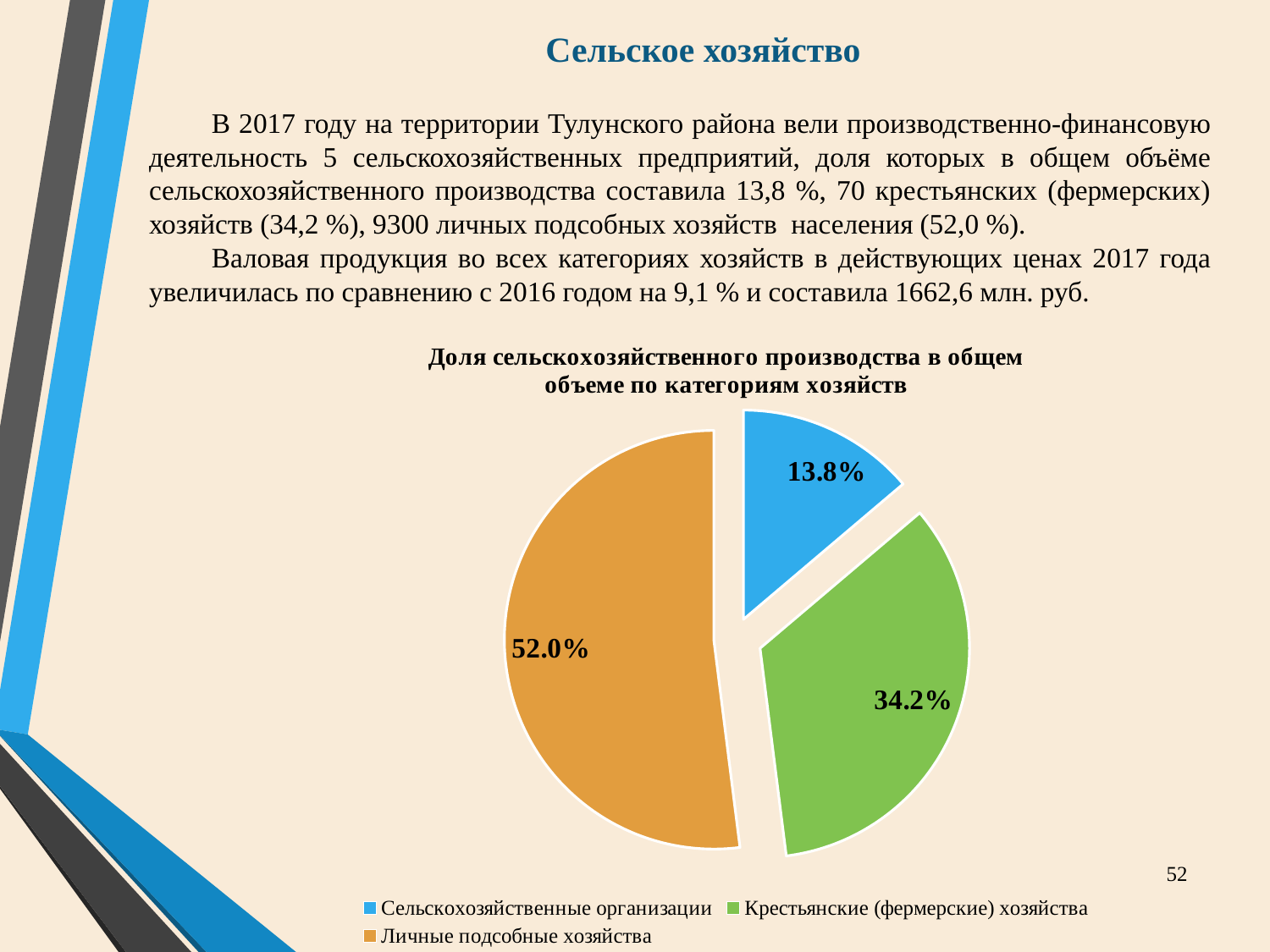
What is the share for Сельскохозяйственные организации? 13.8% How many categories does the pie chart have? 3 What is the difference between the shares of Крестьянские (фермерские) хозяйства and Сельскохозяйственные организации? 20.4% What is the share for Крестьянские (фермерские) хозяйства? 34.2% Which category has the smallest share of the pie? Сельскохозяйственные организации Which category has the largest share of the pie? Личные подсобные хозяйства Which is larger: the share of Крестьянские (фермерские) хозяйства or Сельскохозяйственные организации? Крестьянские (фермерские) хозяйства What is the share for Личные подсобные хозяйства? 52.0% What is the difference between the shares of Личные подсобные хозяйства and Крестьянские (фермерские) хозяйства? 17.8% What type of chart is shown on the slide? pie chart What colour is the slice for Личные подсобные хозяйства? orange What is the title of the pie chart? Доля сельскохозяйственного производства в общем объеме по категориям хозяйств